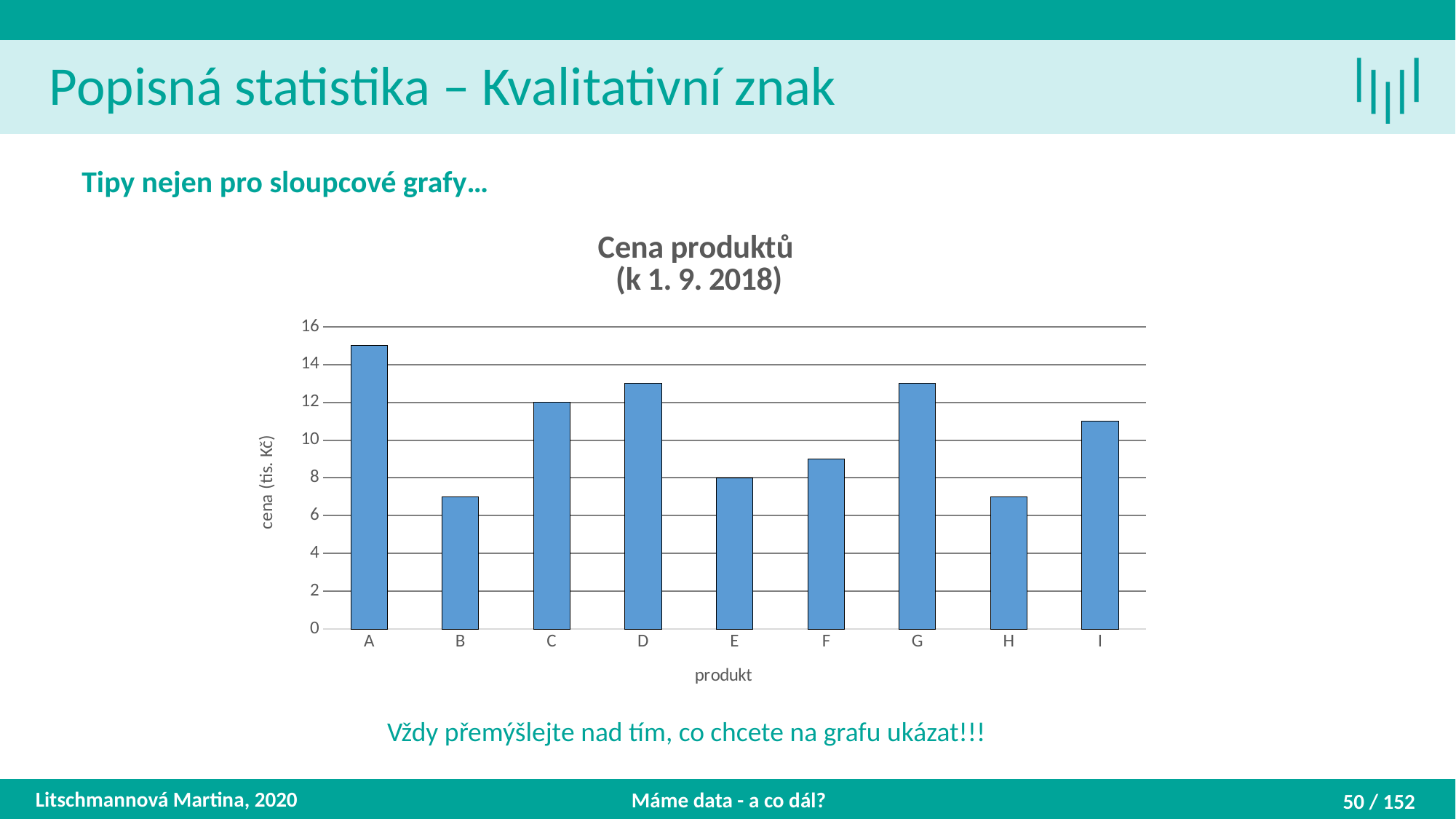
What is the value for product E? 8 What type of chart is shown on the slide? bar chart Which product has the highest value in the chart? A Which has a larger value, product D or product F? D What is the title of the chart? Cena produktů (k 1. 9. 2018) What is the label of the vertical axis of the chart? cena (tis. Kč) Is the value for product A greater or less than 14? greater How many products (categories) are shown on the x axis of the chart? 9 Is the value for product H greater or less than 8? less Which has a larger value, product A or product B? A What is the value for product C? 12 What is the difference between the values for product C and product E? 4